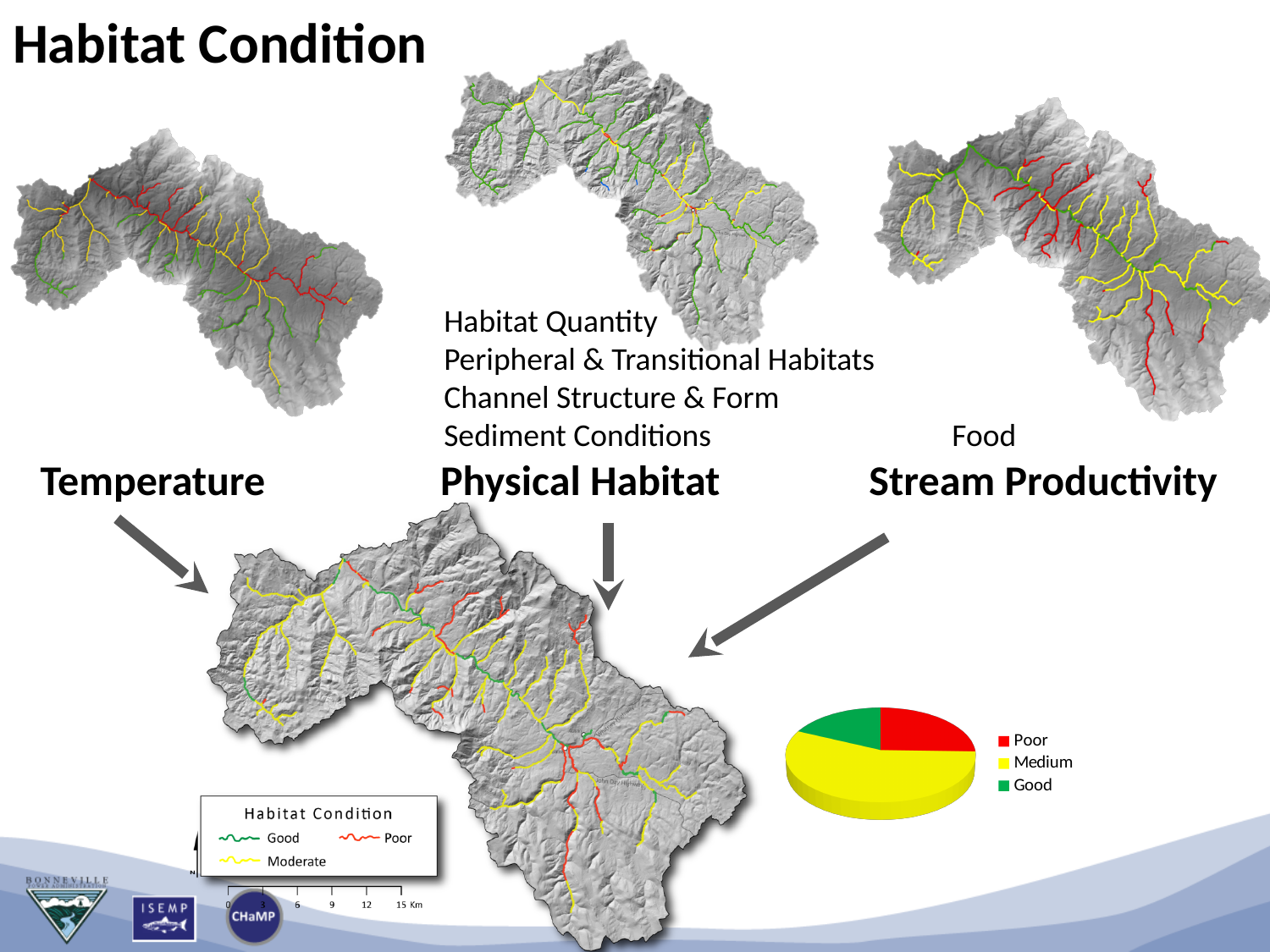
What are the three categories listed in the pie chart's legend? Poor, Medium, Good Does the Medium slice make up more or less than half of the pie chart? more Which category has the smallest slice in the pie chart? Good How many categories does the pie chart's legend list? 3 What kind of chart is shown at the bottom right of the slide? pie chart In the pie chart, which slice is larger, Medium or Poor? Medium In the pie chart, which slice is larger, Poor or Good? Poor What colour represents the Good category in the pie chart? green Which category has the largest slice in the pie chart? Medium What colour represents the Poor category in the pie chart? red